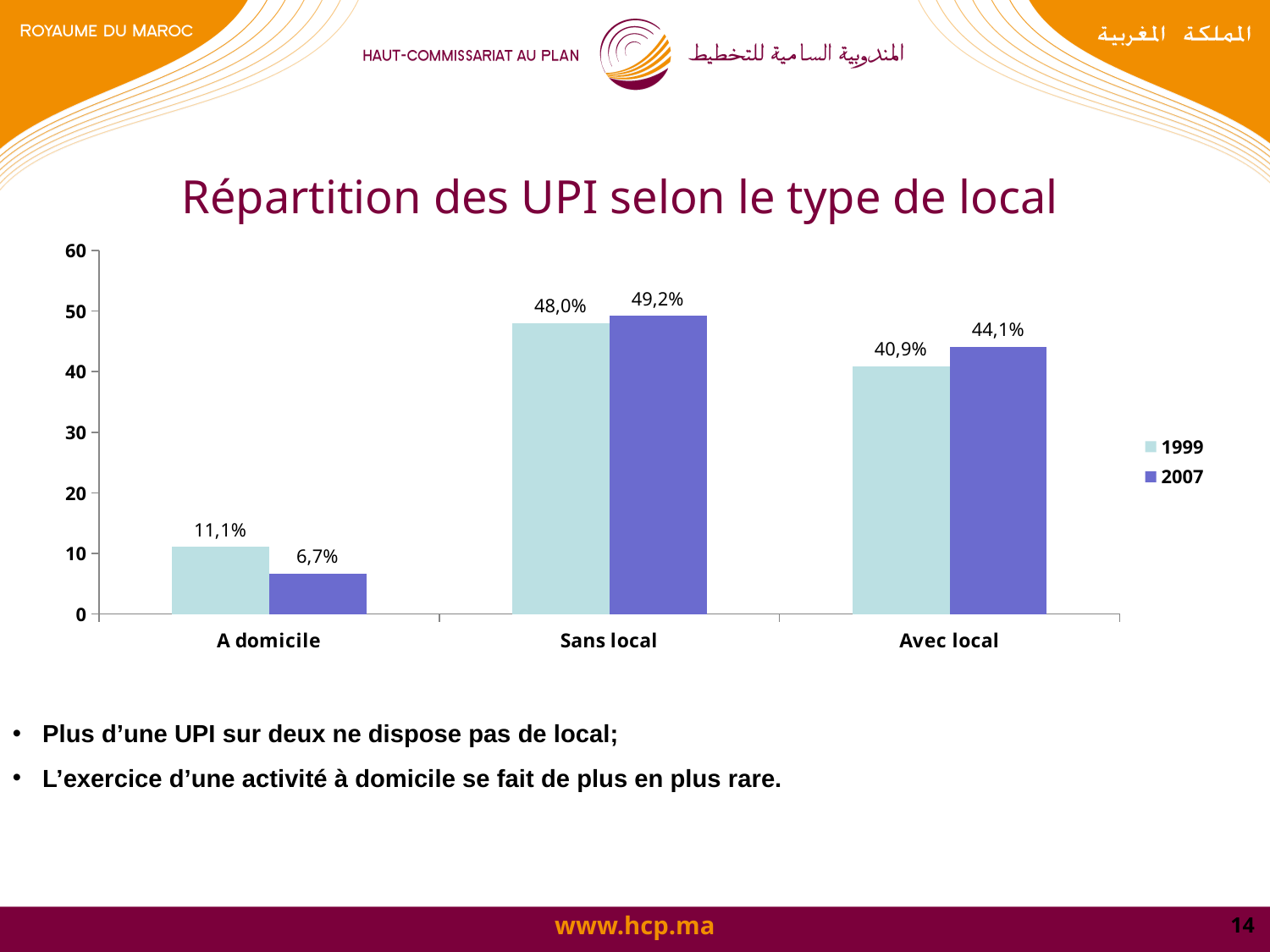
What is the difference between the 2007 and 1999 values for 'Avec local'? 3,2 What is the value for 'Avec local' in 1999? 40,9% What is the title of the chart? Répartition des UPI selon le type de local What is the value for 'A domicile' in 2007? 6,7% How many categories are shown on the x axis? 3 Which category has the highest value in 2007? Sans local Which category has the lowest value in 1999? A domicile What kind of chart is shown on the slide? Bar chart Which is larger for 'A domicile': the 1999 value or the 2007 value? 1999 Is the value for 'Sans local' in 2007 greater or less than 40? greater How many series does the legend list? 2 What is the value for 'Sans local' in 1999? 48,0%